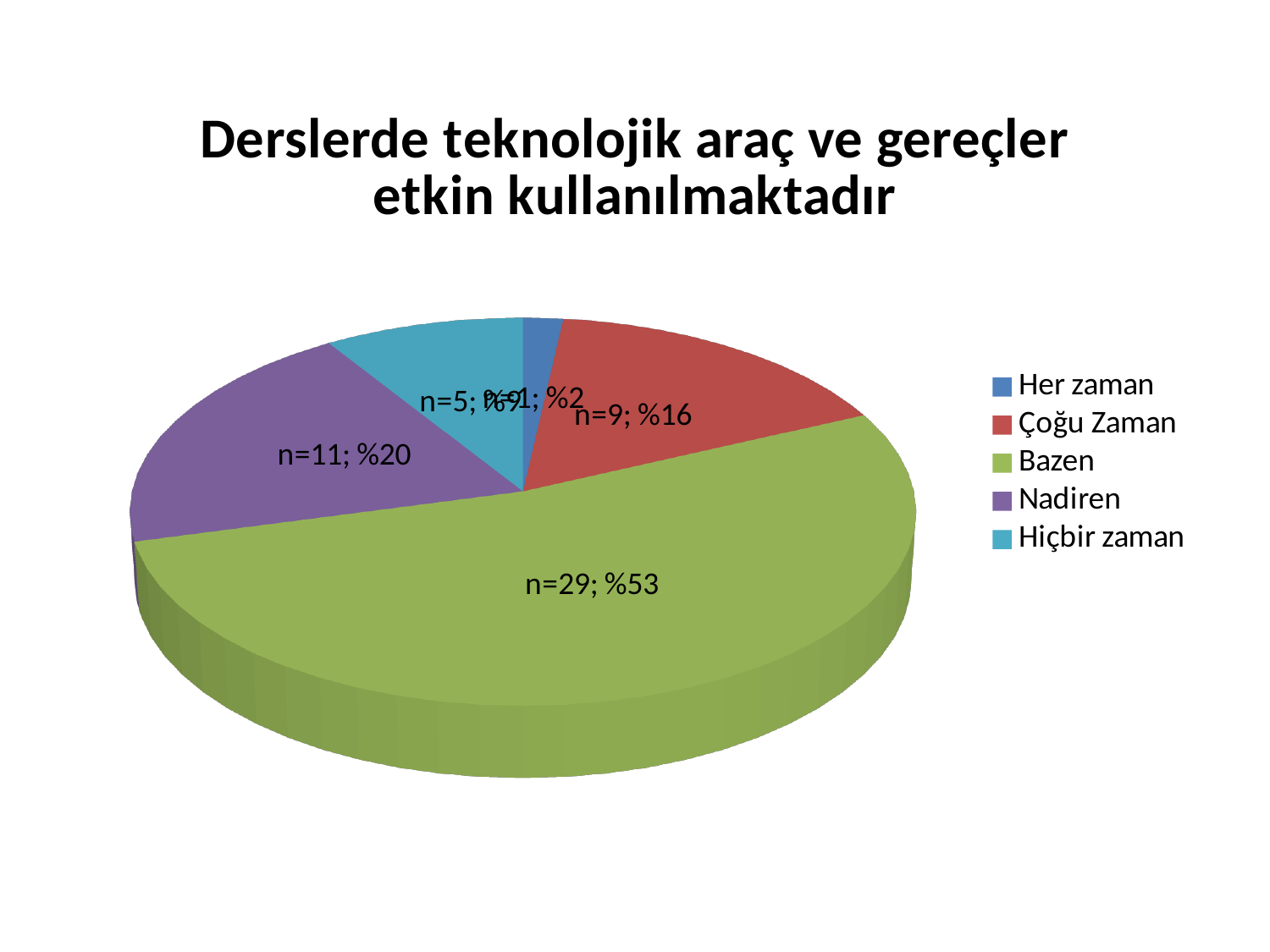
How many categories does the pie chart have? 5 What kind of chart is shown on the slide? pie chart Which category has the smallest slice of the pie? Her zaman Which slice is larger, Nadiren or Çoğu Zaman? Nadiren What is the title of the chart? Derslerde teknolojik araç ve gereçler etkin kullanılmaktadır What is the data label for the Bazen slice? n=29; %53 What colour is the Bazen slice in the pie chart? green What is the data label for the Çoğu Zaman slice? n=9; %16 Which category has the largest slice of the pie? Bazen What is the data label for the Nadiren slice? n=11; %20 What is the difference in n between the Bazen slice and the Nadiren slice? 18 What share of the pie does the Bazen slice represent? %53